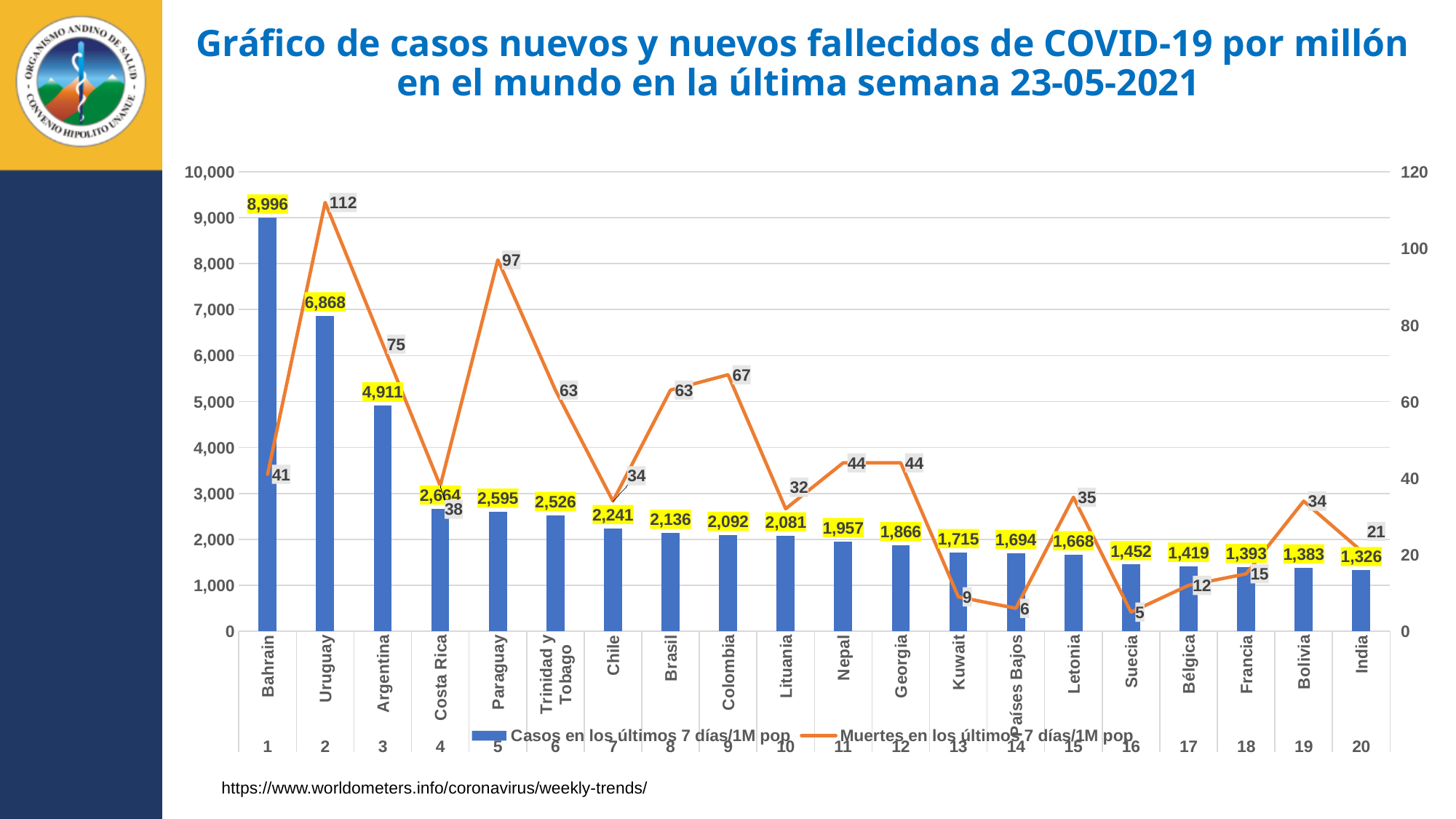
What is the difference between the 'Casos en los últimos 7 días/1M pop' values for Bahrain and Uruguay? 2,128 Which country has the highest value for 'Casos en los últimos 7 días/1M pop'? Bahrain Which country has the lowest value for 'Muertes en los últimos 7 días/1M pop'? Suecia Do the 'Casos en los últimos 7 días/1M pop' values rise or fall from Bahrain to India along the x axis? Fall How many series does the legend list? 2 What is the value of 'Muertes en los últimos 7 días/1M pop' for Paraguay? 97 What kind of chart is used for the 'Casos en los últimos 7 días/1M pop' series? Bar chart Is the 'Casos en los últimos 7 días/1M pop' value for Chile greater or less than 3,000? less Which has a higher 'Muertes en los últimos 7 días/1M pop' value, Argentina or Colombia? Argentina How many countries are shown on the x axis of the chart? 20 What is the value of 'Casos en los últimos 7 días/1M pop' for Uruguay? 6,868 What is the value of 'Muertes en los últimos 7 días/1M pop' for India? 21